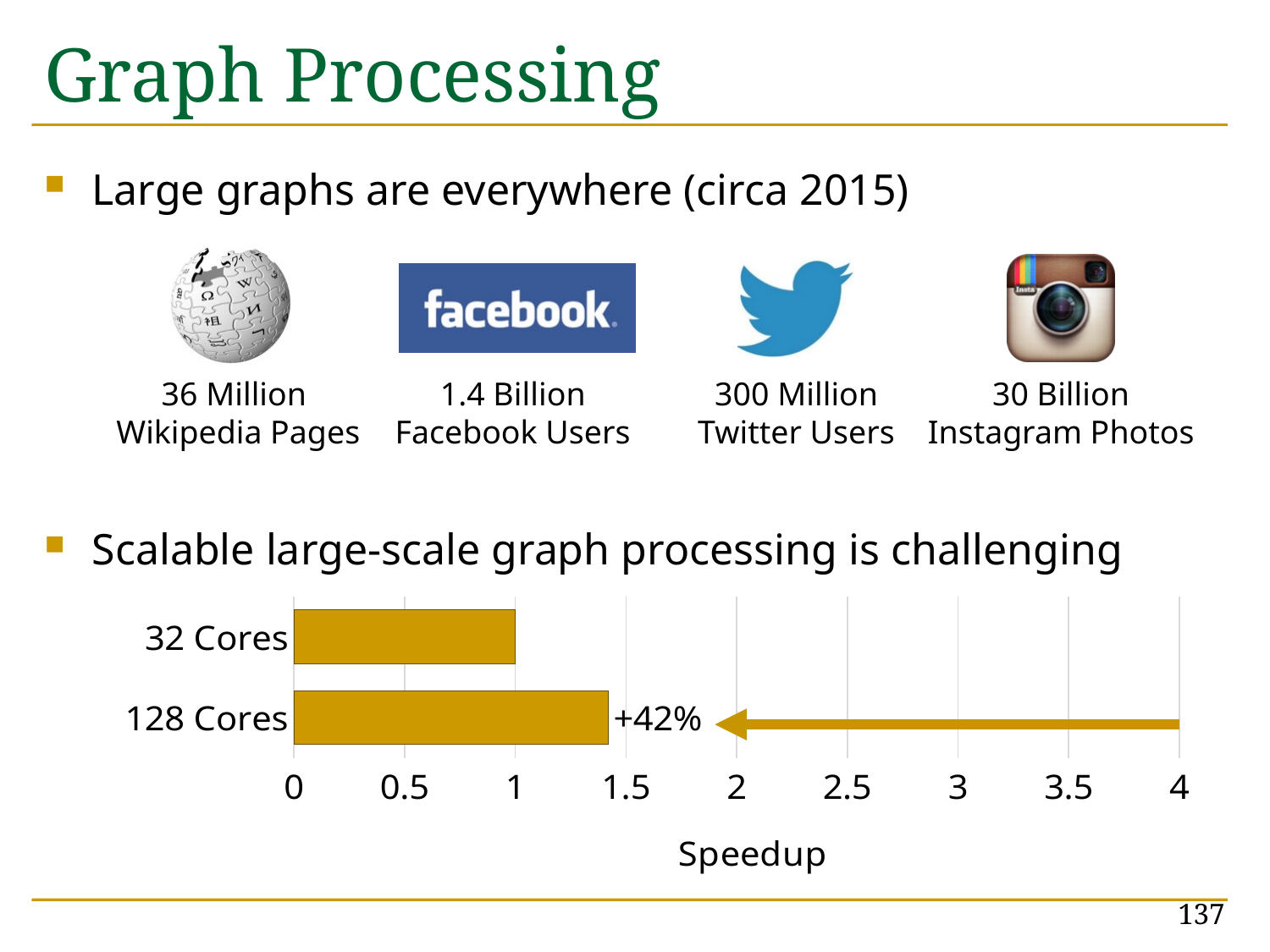
Which category has the highest speedup? 128 Cores Is the speedup for 128 Cores greater or less than 1? greater How many categories are plotted in the chart? 2 Which category has the lowest speedup? 32 Cores What annotation is printed next to the 128 Cores bar? +42% What kind of chart is shown on the slide? bar chart What is the speedup value for 32 Cores? 1 Is the speedup for 32 Cores greater or less than 2? less Which has a larger speedup, 32 Cores or 128 Cores? 128 Cores Is the speedup for 128 Cores greater or less than 2? less What is the title of the x axis of the chart? Speedup